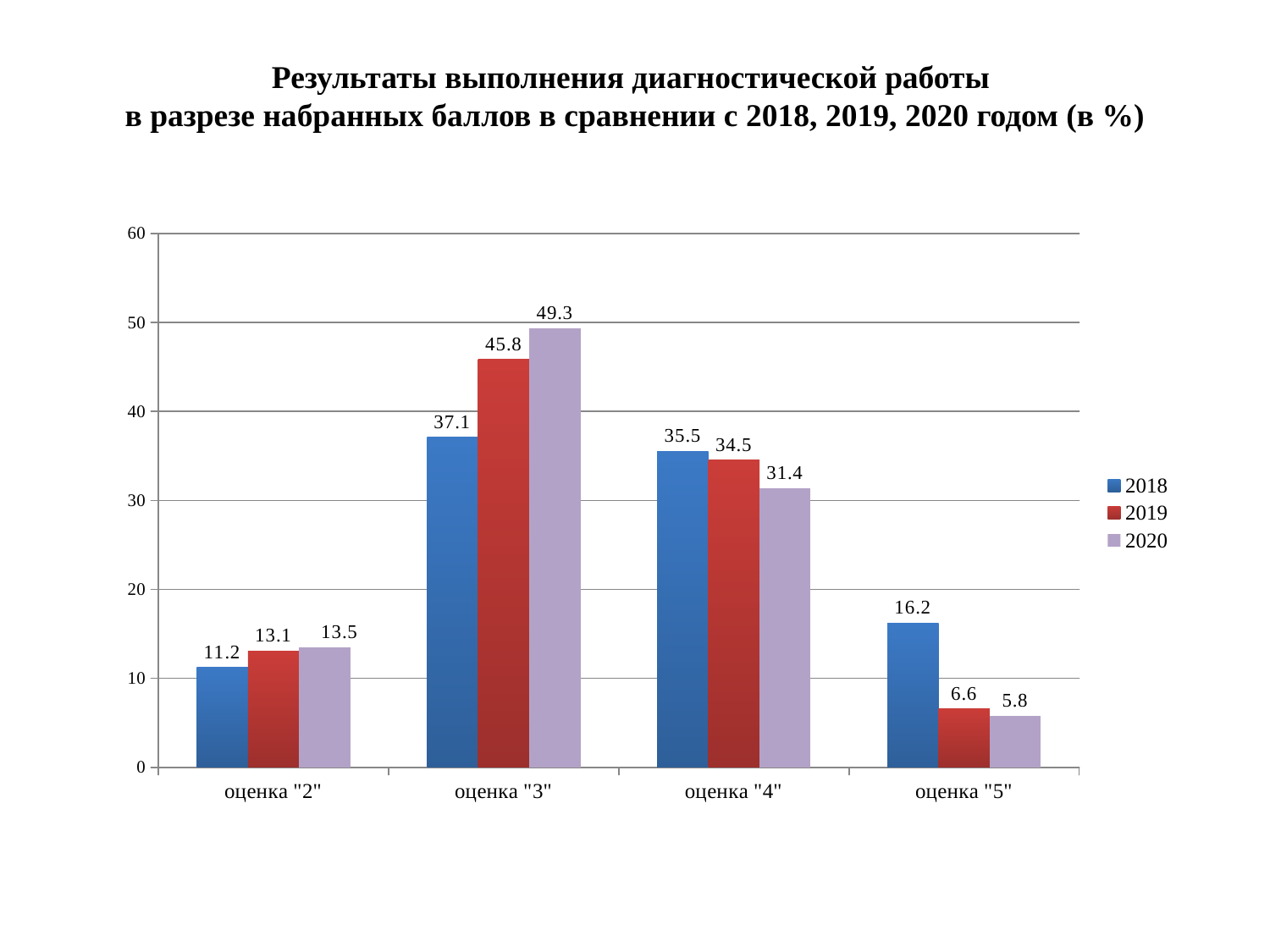
Which category has the highest value for the 2020 series? оценка "3" What is the difference between the 2020 and 2018 values in the category оценка "3"? 12.2 What is the value for 2020 in the category оценка "3"? 49.3 What kind of chart is shown on the slide? bar chart In the category оценка "5", which series has the larger value, 2018 or 2020? 2018 What is the value for 2019 in the category оценка "4"? 34.5 Is the value for 2019 in the category оценка "3" greater or less than 40? greater How many series does the legend list? 3 How many categories are shown on the x axis? 4 Which category has the lowest value for the 2019 series? оценка "5" Which colour represents the 2019 series in the legend? red What is the value for 2018 in the category оценка "5"? 16.2